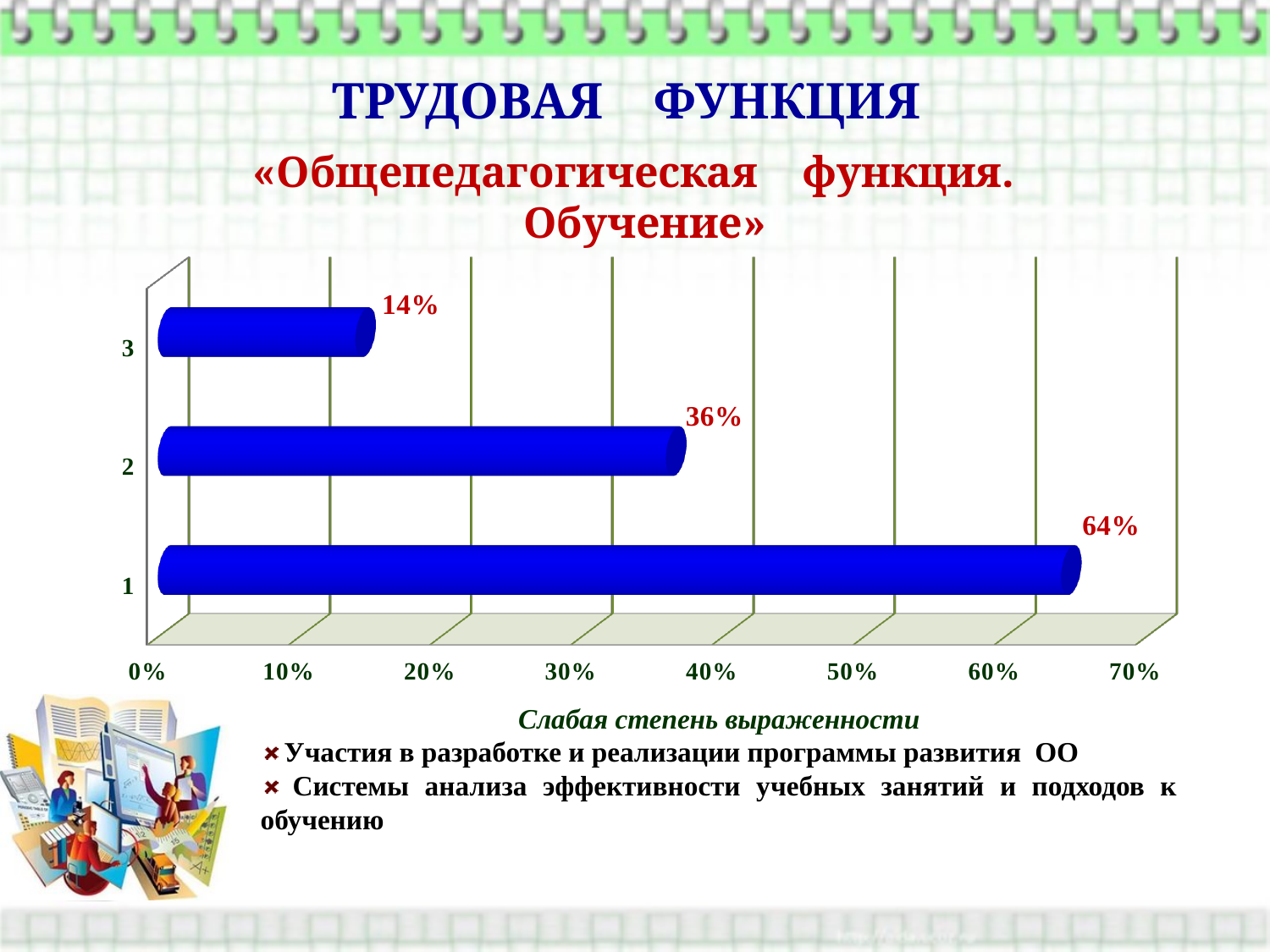
How many categories are shown in the chart? 3 What is the difference between the values for category 1 and category 2? 28% Which category has the highest value? 1 Is the value for category 1 greater or less than 60%? greater What is the difference between the values for category 2 and category 3? 22% What is the value for category 3? 14% What is the value for category 2? 36% What is the value for category 1? 64% Which is larger, the value for category 2 or the value for category 3? category 2 What is the highest value shown on the horizontal axis? 70% Which category has the lowest value? 3 What kind of chart is shown on the slide? bar chart